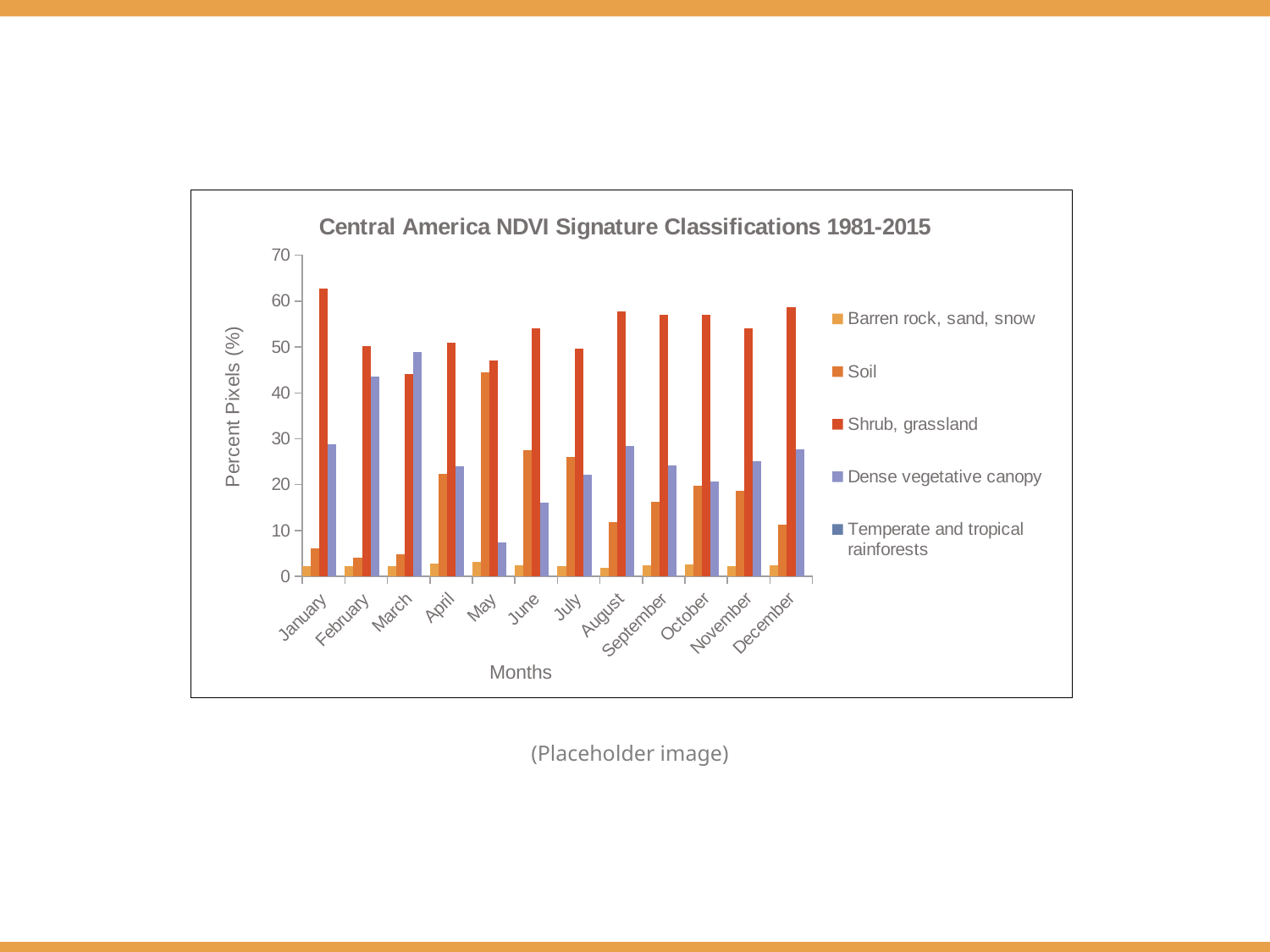
How many series does the legend list? 5 Is the value for Dense vegetative canopy in May greater or less than 10? less Which month has the lowest value for Dense vegetative canopy? May Is the value for Soil in May greater or less than 40? greater Which month has the highest value for Shrub, grassland? January Is the value for Shrub, grassland in January greater or less than 60? greater What kind of chart is shown on the slide? Bar chart What is the title of the chart? Central America NDVI Signature Classifications 1981-2015 In May, which is larger: Soil or Dense vegetative canopy? Soil In March, which is larger: Dense vegetative canopy or Shrub, grassland? Dense vegetative canopy How many months are shown on the x axis? 12 Which month has the highest value for Soil? May